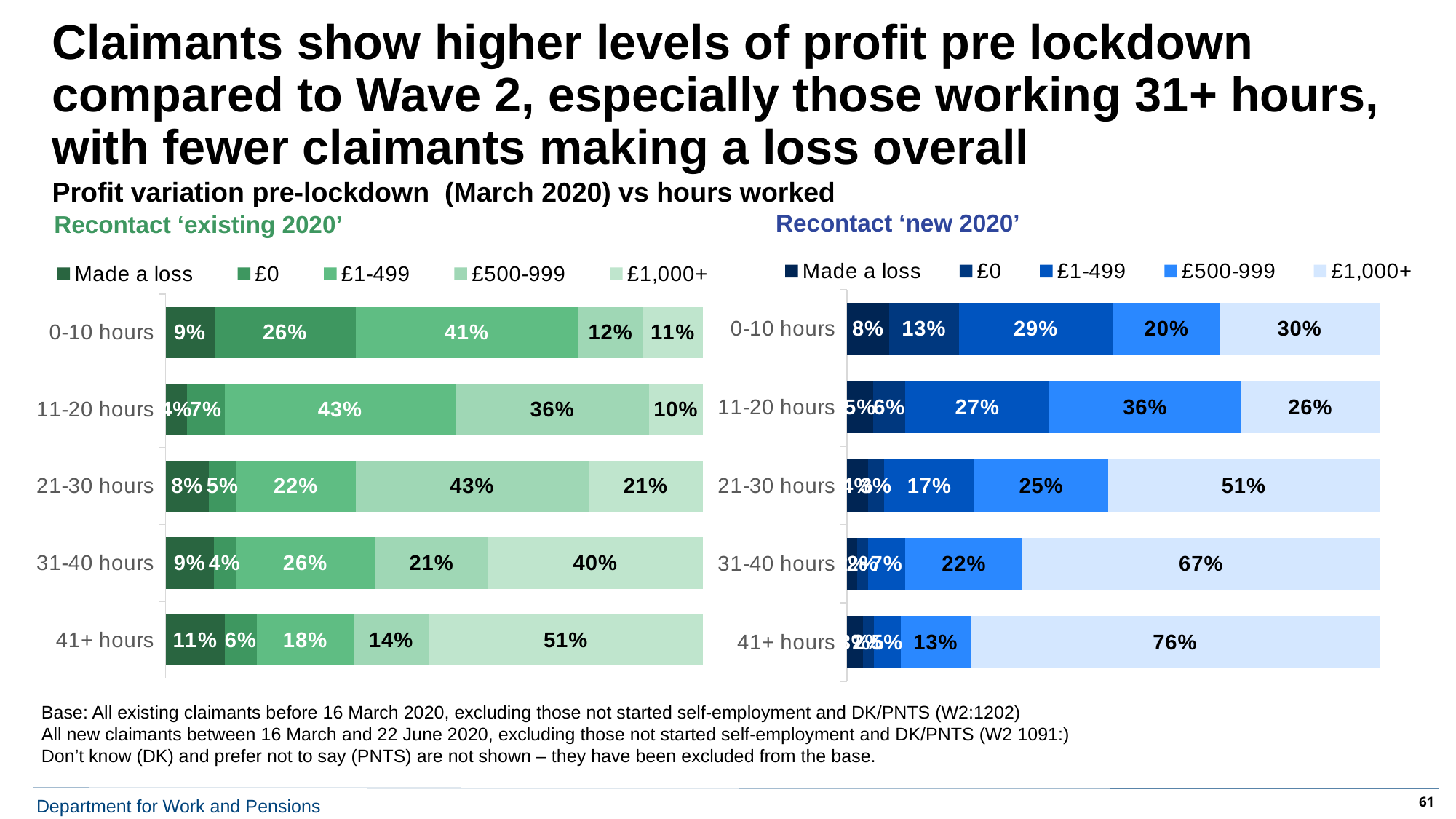
How many series does the legend of the Recontact 'new 2020' chart list? 5 In the Recontact 'existing 2020' chart, which hours category has the lowest £1,000+ value? 11-20 hours In the Recontact 'existing 2020' chart, what is the combined share of £500-999 and £1,000+ for 31-40 hours? 61% In the Recontact 'existing 2020' chart, what is the £1,000+ value for 41+ hours? 51% In the Recontact 'new 2020' chart, which hours category has the highest £1,000+ value? 41+ hours How many hours categories are shown in the Recontact 'existing 2020' chart? 5 In the Recontact 'new 2020' chart, what is the £1,000+ value for 41+ hours? 76% What type of chart is the Recontact 'existing 2020' chart? Stacked bar chart In the Recontact 'new 2020' chart, what is the £500-999 value for 11-20 hours? 36% In the Recontact 'new 2020' chart, which is larger: the £1,000+ value for 21-30 hours or for 31-40 hours? 31-40 hours In the Recontact 'existing 2020' chart, what is the difference between the £1-499 values for 0-10 hours and 41+ hours? 23% In the Recontact 'existing 2020' chart, what percentage of claimants working 0-10 hours made a loss? 9%